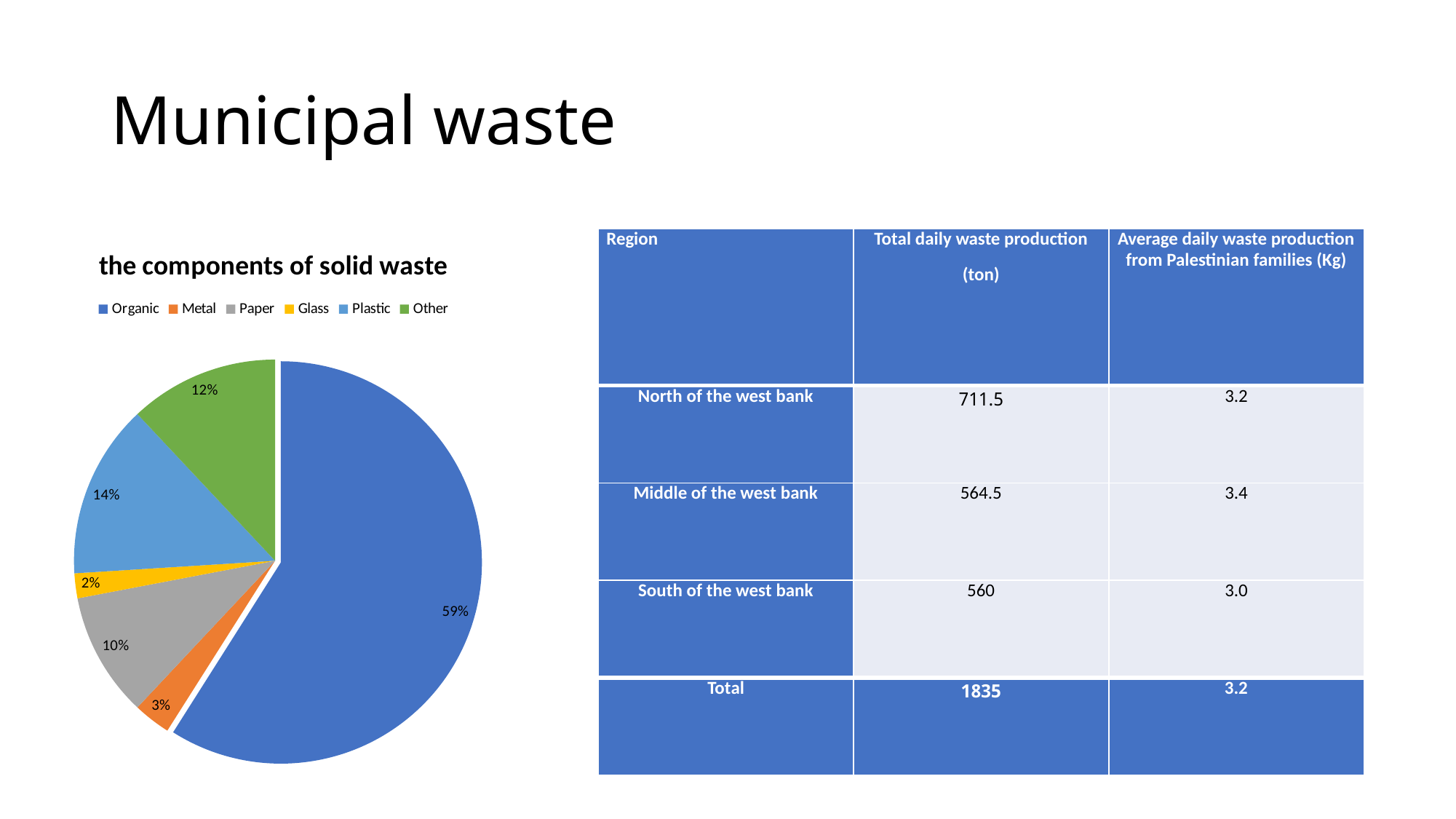
What is the difference in percentage points between the Organic share and the Plastic share? 45 Which has a larger share of solid waste, Plastic or Other? Plastic What kind of chart is shown on the slide? pie chart What is the title of the chart? the components of solid waste What share of solid waste is Plastic? 14% Which component has the largest share of solid waste? Organic What share of solid waste is Organic? 59% How many categories does the legend of the pie chart list? 6 What share of solid waste is Paper? 10% What share of solid waste is Glass? 2% What share of solid waste is Metal? 3% Which component has the smallest share of solid waste? Glass